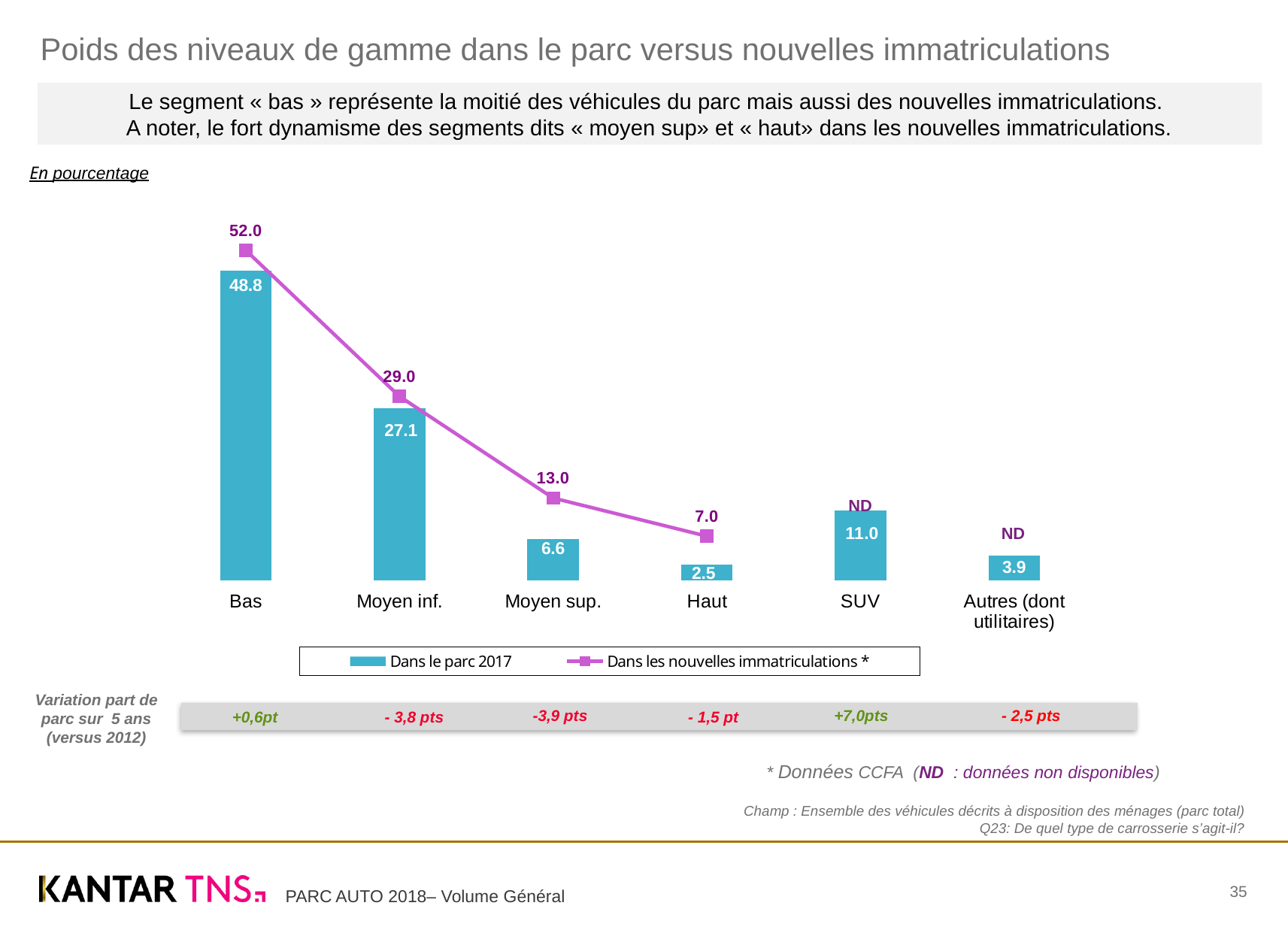
What is the value for "Bas" in the "Dans le parc 2017" series? 48.8 How many series does the chart legend list? 2 What is the difference between the "Dans les nouvelles immatriculations *" value and the "Dans le parc 2017" value for "Moyen sup."? 6.4 How many categories are shown on the x axis of the chart? 6 Does the "Dans les nouvelles immatriculations *" line rise or fall from "Bas" to "Haut"? fall Which is larger for "Bas": the "Dans le parc 2017" value or the "Dans les nouvelles immatriculations *" value? Dans les nouvelles immatriculations * What label is shown for the "Dans les nouvelles immatriculations *" series at "SUV" and "Autres (dont utilitaires)"? ND What is the value for "SUV" in the "Dans le parc 2017" series? 11.0 What is the value for "Moyen inf." in the "Dans les nouvelles immatriculations *" series? 29.0 Which category has the lowest value in the "Dans le parc 2017" series? Haut Which category has the highest value in the "Dans le parc 2017" series? Bas What is the value for "Haut" in the "Dans les nouvelles immatriculations *" series? 7.0